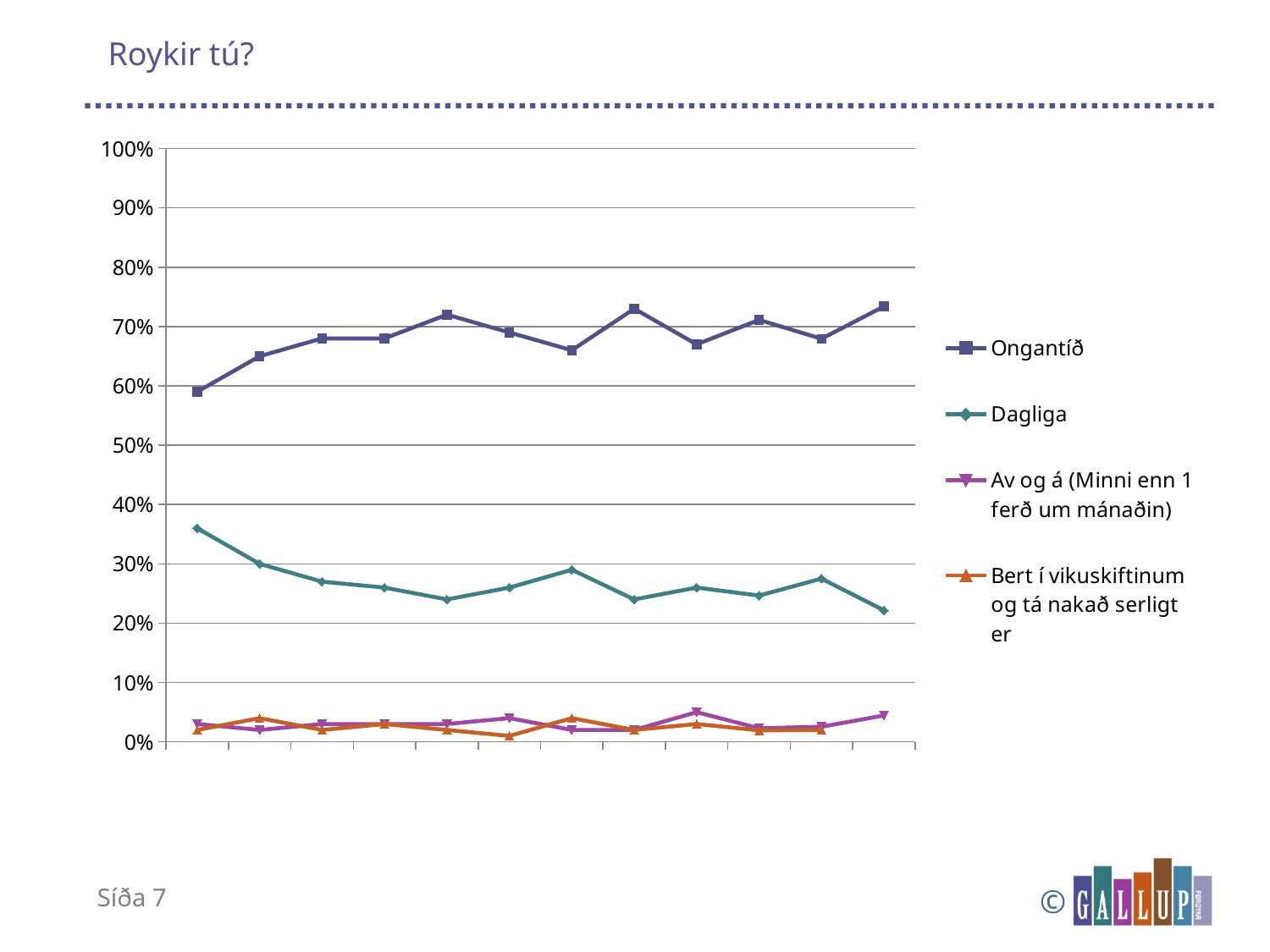
Is the first value of the Dagliga series greater or less than 30%? greater Is the first value of the Ongantíð series greater or less than 50%? greater At the first point on the x axis, which is larger: Ongantíð or Dagliga? Ongantíð Does the Dagliga series generally rise or fall from left to right? fall Is the last value of the Ongantíð series greater or less than 60%? greater Does the Ongantíð series generally rise or fall from left to right? rise What is the title of the slide containing the chart? Roykir tú? Which series has the highest values across the chart? Ongantíð How many series does the legend list? 4 What kind of chart is shown on the slide? line chart Which legend entry is shown with square markers? Ongantíð